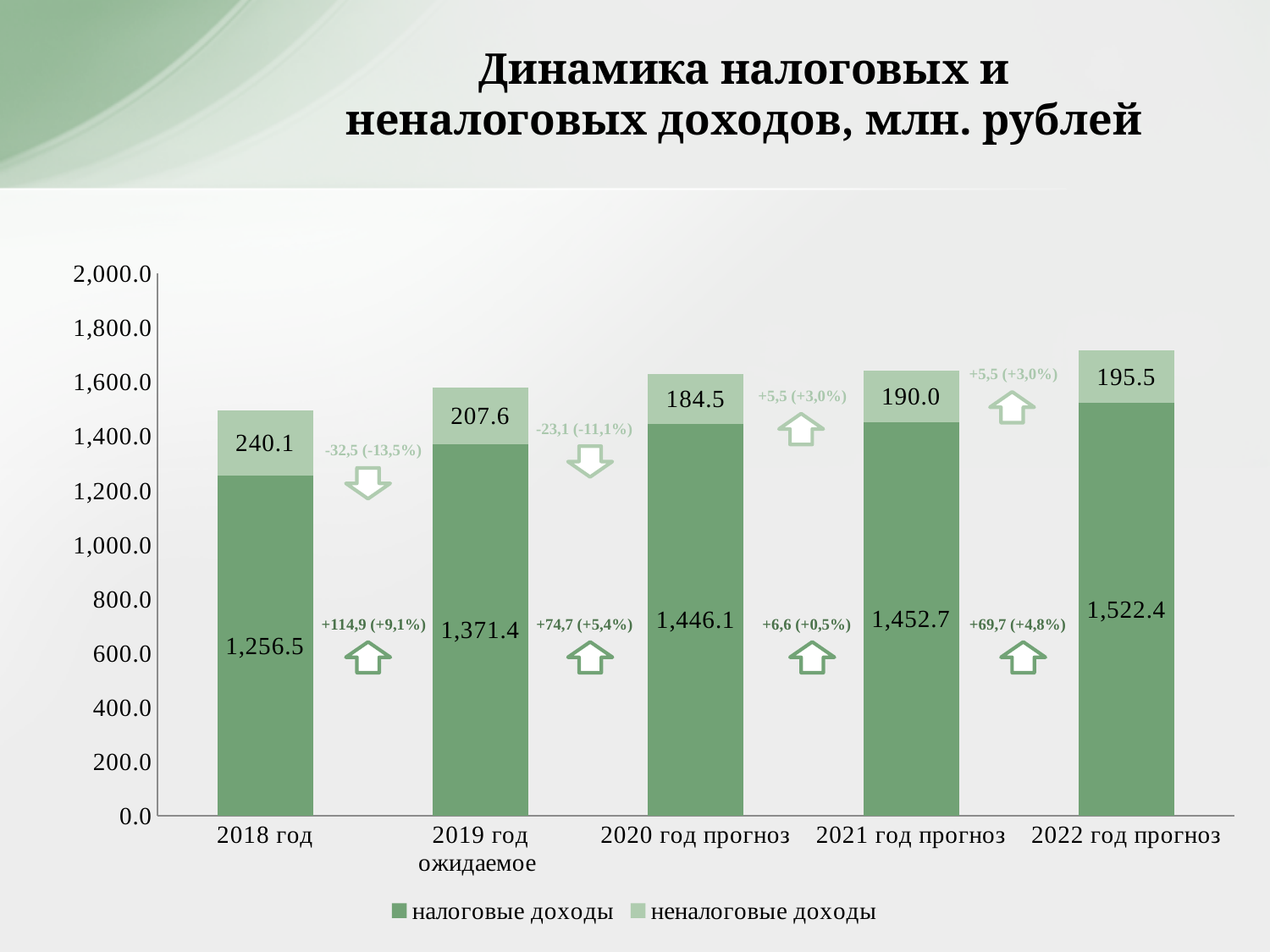
How many series does the legend list? 2 What is the value of неналоговые доходы for 2022 год прогноз? 195.5 What is the total of the stacked bar for 2018 год? 1,496.6 Which year has the lowest value of неналоговые доходы? 2020 год прогноз Do the values of налоговые доходы rise or fall from 2018 год to 2022 год прогноз? rise Which is larger: неналоговые доходы in 2019 год ожидаемое or in 2021 год прогноз? 2019 год ожидаемое Which year has the highest value of налоговые доходы? 2022 год прогноз What is the difference between налоговые доходы in 2022 год прогноз and in 2018 год? 265.9 How many years (categories) are shown on the x axis? 5 What is the value of налоговые доходы for 2020 год прогноз? 1,446.1 Which year has the highest value of неналоговые доходы? 2018 год What is the value of налоговые доходы for 2018 год? 1,256.5